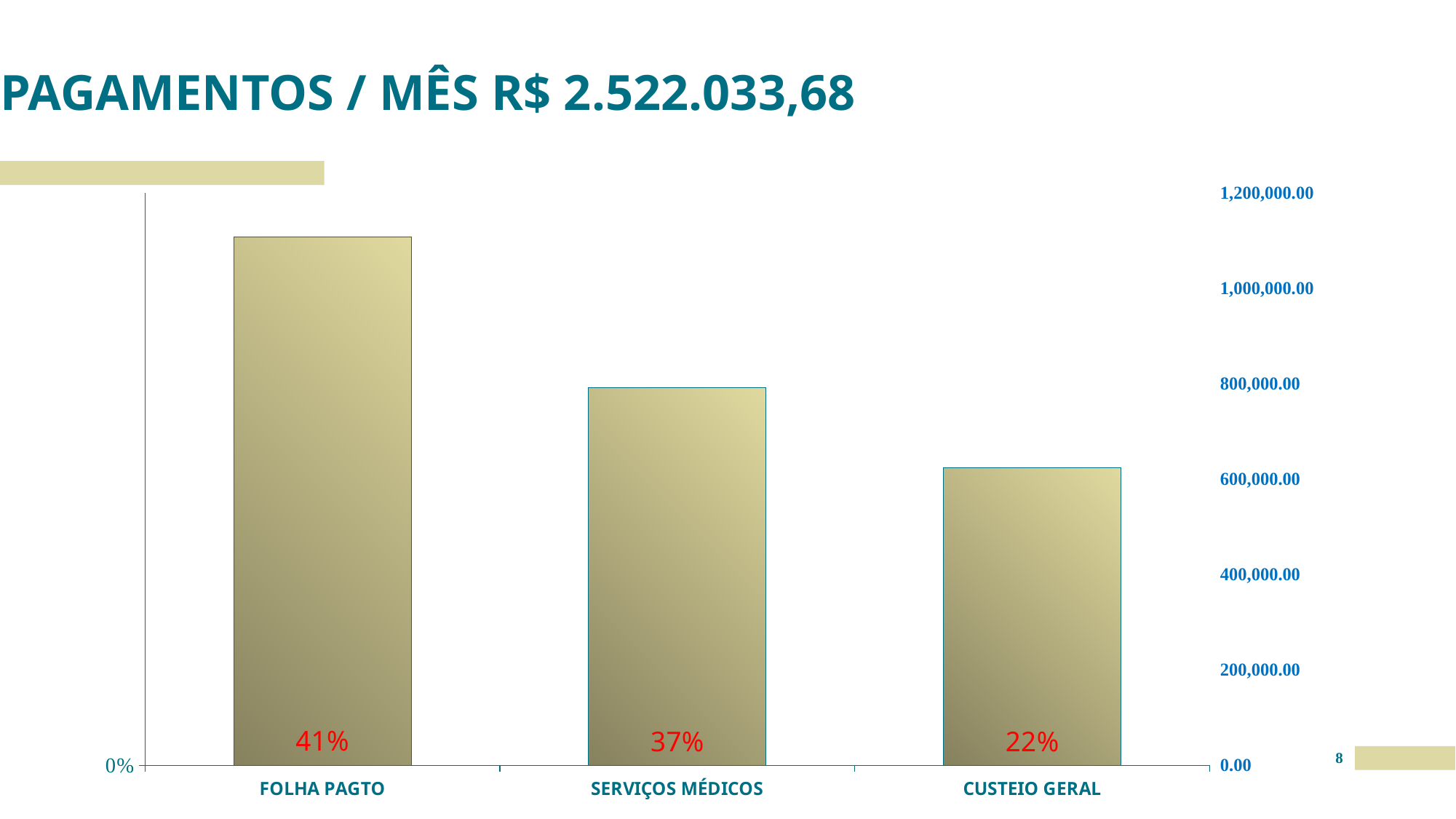
What percentage label is shown on the CUSTEIO GERAL bar? 22% How many categories are shown on the x axis? 3 Is the value for CUSTEIO GERAL greater or less than 800,000.00? less What kind of chart is shown on the slide? bar chart Which is larger, the bar for SERVIÇOS MÉDICOS or the bar for CUSTEIO GERAL? SERVIÇOS MÉDICOS Do the bar values rise or fall from left to right along the x axis? fall Is the value for FOLHA PAGTO greater or less than 1,000,000.00? greater What percentage label is shown on the SERVIÇOS MÉDICOS bar? 37% Which category has the highest bar? FOLHA PAGTO Which category has the lowest bar? CUSTEIO GERAL What percentage label is shown on the FOLHA PAGTO bar? 41% What is the difference in percentage points between the FOLHA PAGTO label and the SERVIÇOS MÉDICOS label? 4